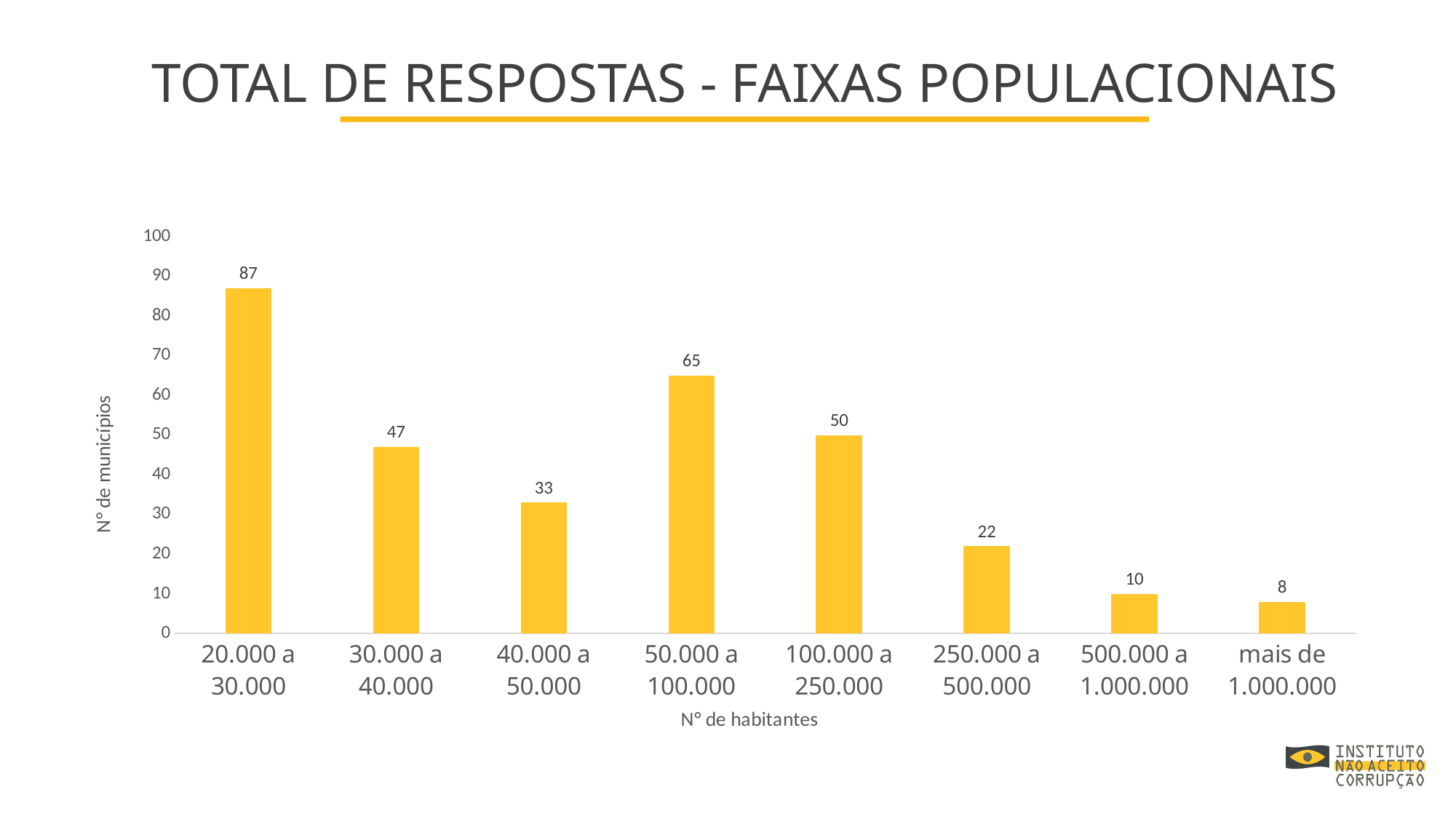
Which population range has the lowest number of municipalities? mais de 1.000.000 How many population ranges are shown on the x axis? 8 What is the label of the y axis? N° de municípios Which is larger: the value for 40.000 a 50.000 or the value for 250.000 a 500.000? 40.000 a 50.000 What is the difference between the values for 50.000 a 100.000 and 100.000 a 250.000? 15 What kind of chart is shown on the slide? Bar chart What is the title of the chart on the slide? TOTAL DE RESPOSTAS - FAIXAS POPULACIONAIS What is the value for the 'mais de 1.000.000' category? 8 Which population range has the highest number of municipalities? 20.000 a 30.000 What is the value for the 50.000 a 100.000 population range? 65 What is the number of municipalities for the population range 20.000 a 30.000? 87 What is the difference between the values for 20.000 a 30.000 and 30.000 a 40.000? 40